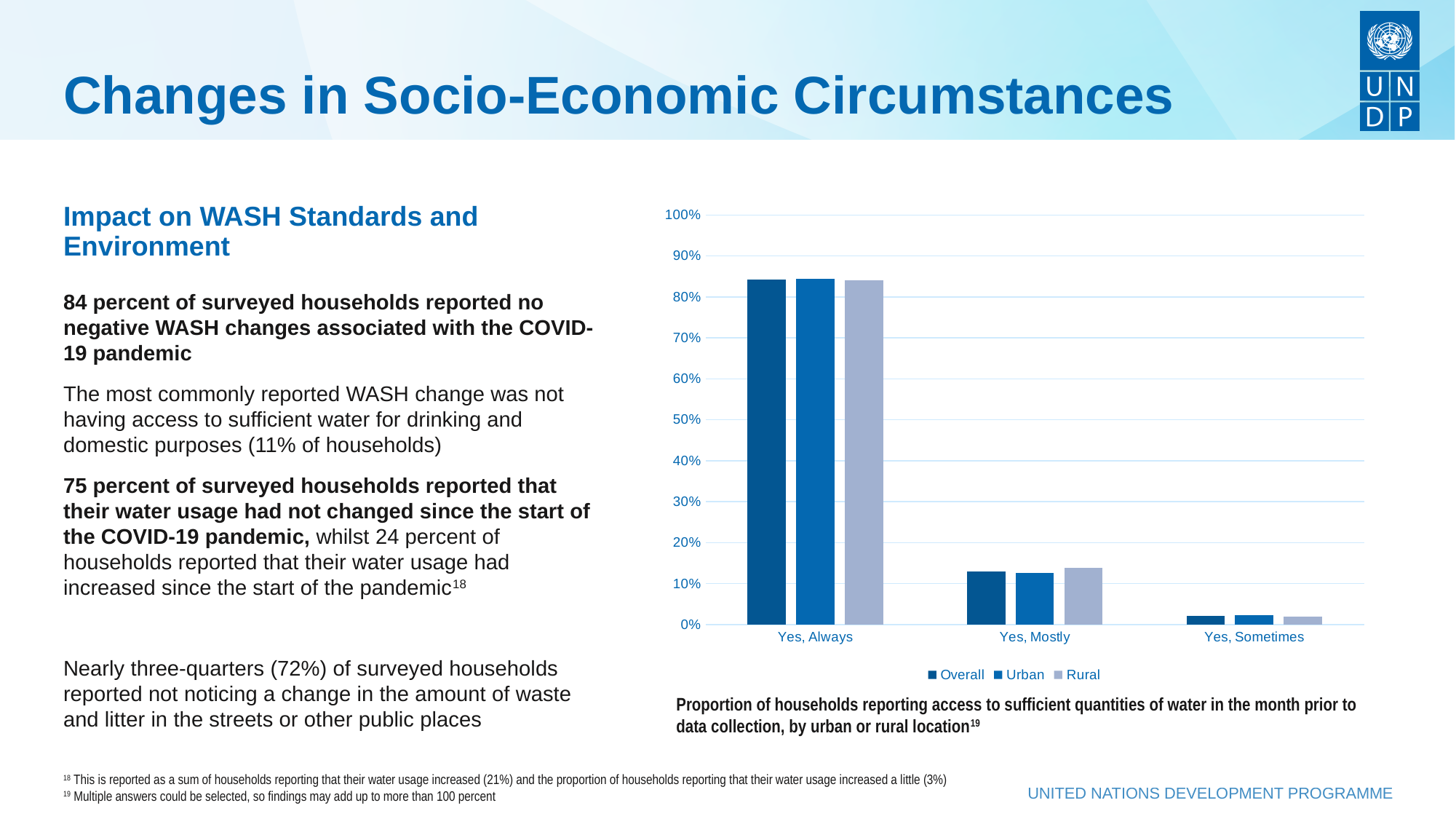
What kind of chart is shown on the slide? bar chart Which is larger for the Overall series: Yes, Always or Yes, Mostly? Yes, Always Is the Overall value for Yes, Always greater or less than 80%? greater Is the Rural value for Yes, Always greater or less than 90%? less Do the values rise or fall moving from Yes, Always to Yes, Sometimes along the x axis? fall What are the three series named in the chart legend? Overall, Urban, Rural Which category has the highest values in the chart? Yes, Always Which category has the lowest values in the chart? Yes, Sometimes How many categories are shown on the x axis of the chart? 3 Is the Urban value for Yes, Mostly greater or less than 20%? less How many series does the chart legend list? 3